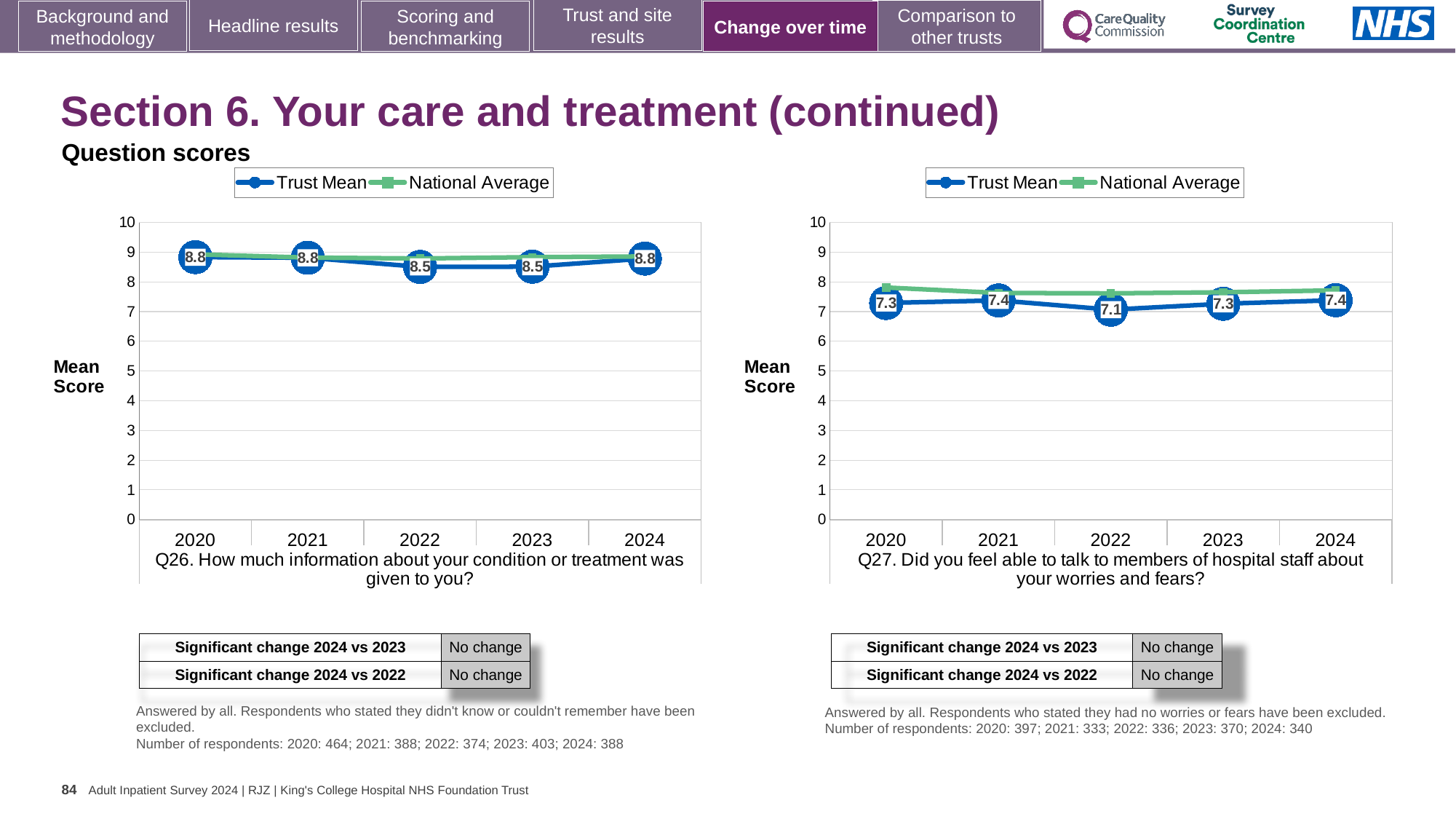
In the Q26 chart on the left, what is the Trust Mean score for 2022? 8.5 In the Q27 chart on the right, which year has the lowest Trust Mean score? 2022 In the Q26 chart on the left, which year has the larger Trust Mean score, 2021 or 2022? 2021 How many series does the legend of the Q27 chart on the right list? 2 What kind of chart is the Q26 chart on the left? Line chart In the Q26 chart on the left, what is the difference between the Trust Mean scores for 2020 and 2022? 0.3 In the Q26 chart on the left, is the National Average value for 2020 greater or less than 8? greater In the Q27 chart on the right, what is the Trust Mean score for 2020? 7.3 In the Q27 chart on the right, what is the difference between the Trust Mean scores for 2021 and 2022? 0.3 How many years are plotted on the x axis of the Q26 chart on the left? 5 In the Q27 chart on the right, is the National Average value for 2020 greater or less than 7? greater In the Q27 chart on the right, which year has the larger Trust Mean score, 2022 or 2024? 2024